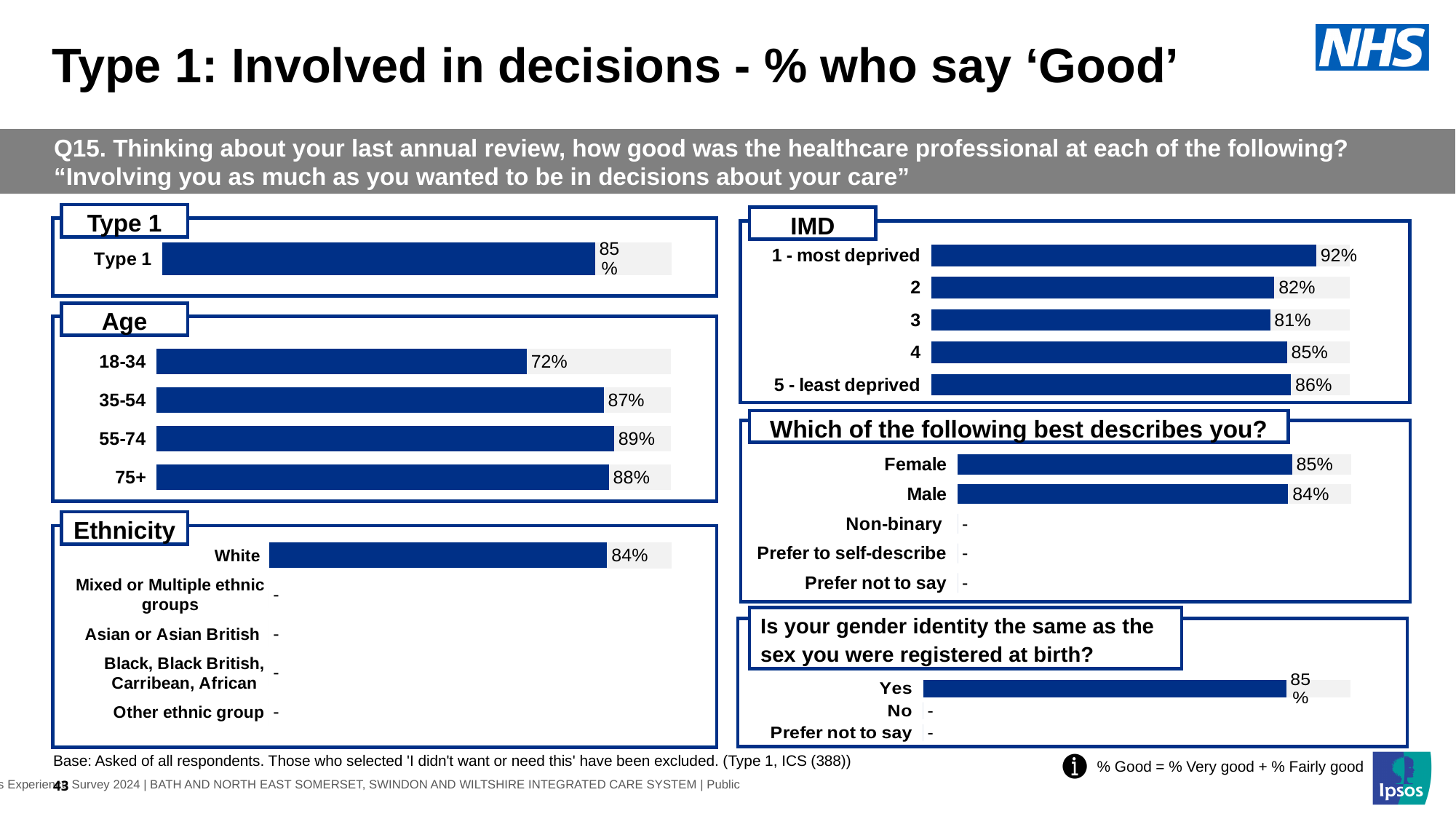
In the IMD chart, which category has the lowest value? 3 In the IMD chart, what is the value for '1 - most deprived'? 92% In the IMD chart, what is the difference between '1 - most deprived' and '5 - least deprived'? 6 percentage points In the Age chart, what is the difference between the 55-74 and 18-34 values? 17 percentage points What type of chart is used in the Age section? Bar chart In the Age chart, which age group has the highest value? 55-74 In the IMD chart, how many categories are shown? 5 In the 'Is your gender identity the same as the sex you were registered at birth?' chart, what is the value for Yes? 85% In the Age chart, which age group has the lowest value? 18-34 In the 'Which of the following best describes you?' chart, which is larger, Female or Male? Female In the Ethnicity chart, what is the value for White? 84% In the Age chart, what is the value for the 18-34 group? 72%